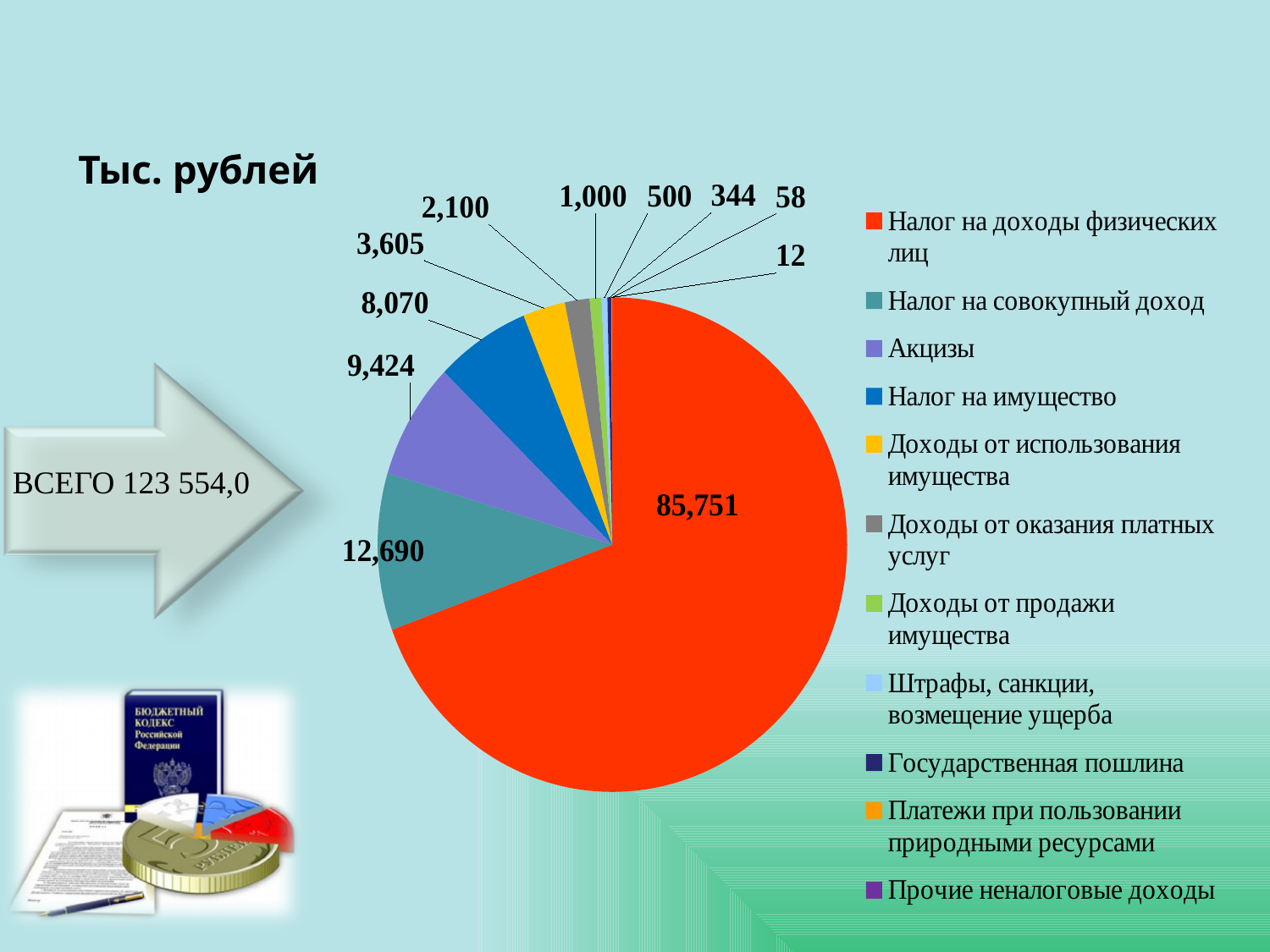
How many categories does the legend list? 11 What is the value for Налог на доходы физических лиц? 85,751 What unit is stated in the heading above the chart? Тыс. рублей What type of chart is shown on the slide? pie chart What is the value for Налог на совокупный доход? 12,690 Which category has the smallest slice of the pie? Прочие неналоговые доходы What is the value for Налог на имущество? 8,070 What is the value for Акцизы? 9,424 What is the value for Доходы от использования имущества? 3,605 Which is larger, the value for Налог на имущество or the value for Доходы от использования имущества? Налог на имущество Which category has the largest slice of the pie? Налог на доходы физических лиц What is the difference between the values for Налог на совокупный доход and Акцизы? 3,266